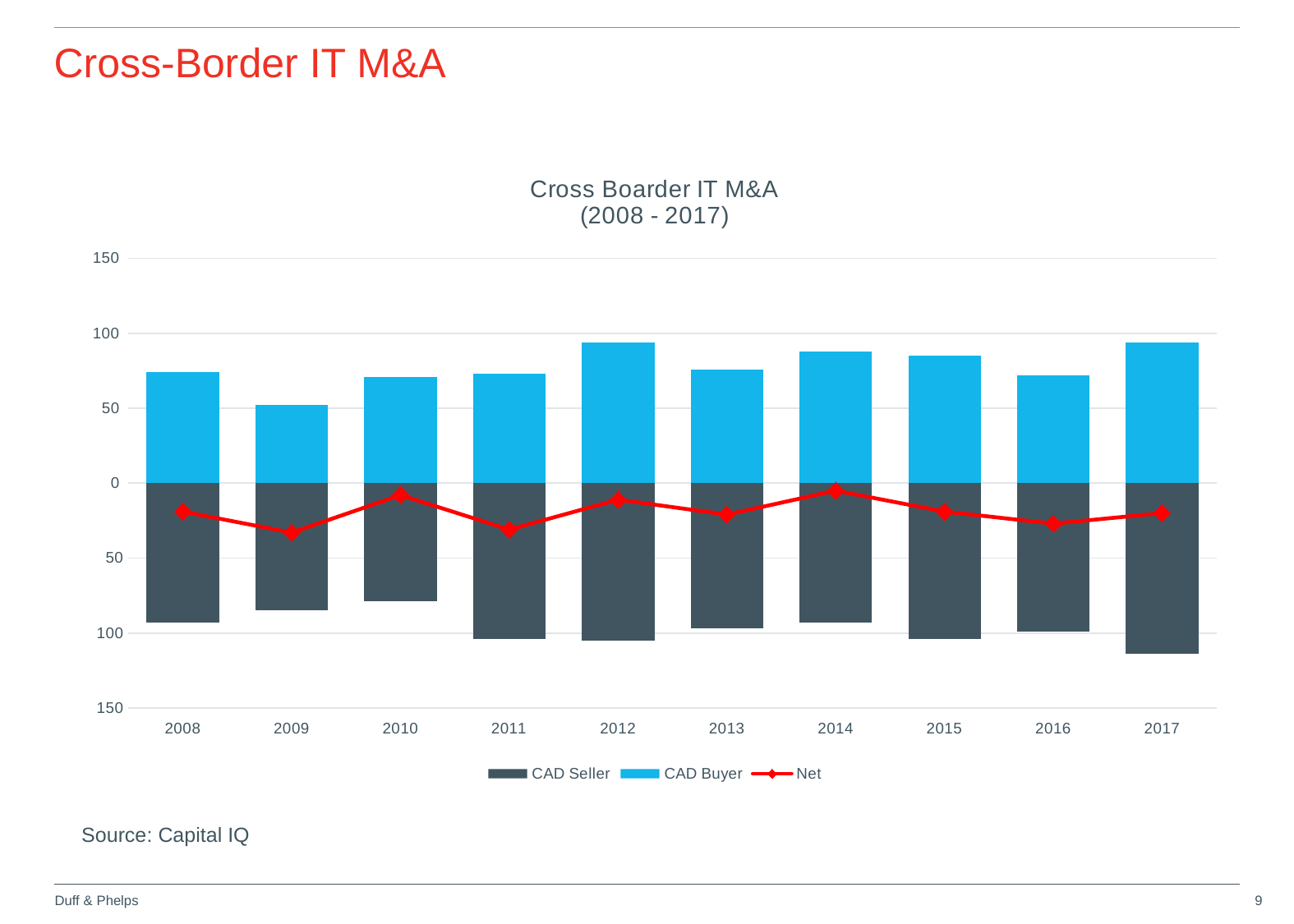
What kind of chart is shown on the slide? A bar chart with a line series What is the title of the chart? Cross Boarder IT M&A (2008 - 2017) Which year has the lowest CAD Buyer value? 2009 Is the CAD Buyer value for 2014 greater or less than 50? greater Which year has the smallest CAD Seller bar? 2010 How many series does the chart's legend list? 3 Does the CAD Buyer value rise or fall from 2008 to 2009? fall Which year has the larger CAD Buyer value, 2009 or 2014? 2014 How many years are shown on the x axis of the chart? 10 Is the CAD Seller bar for 2010 greater or less than 100? less Which year has the largest CAD Seller bar? 2017 Is the CAD Seller bar for 2017 greater or less than 100? greater